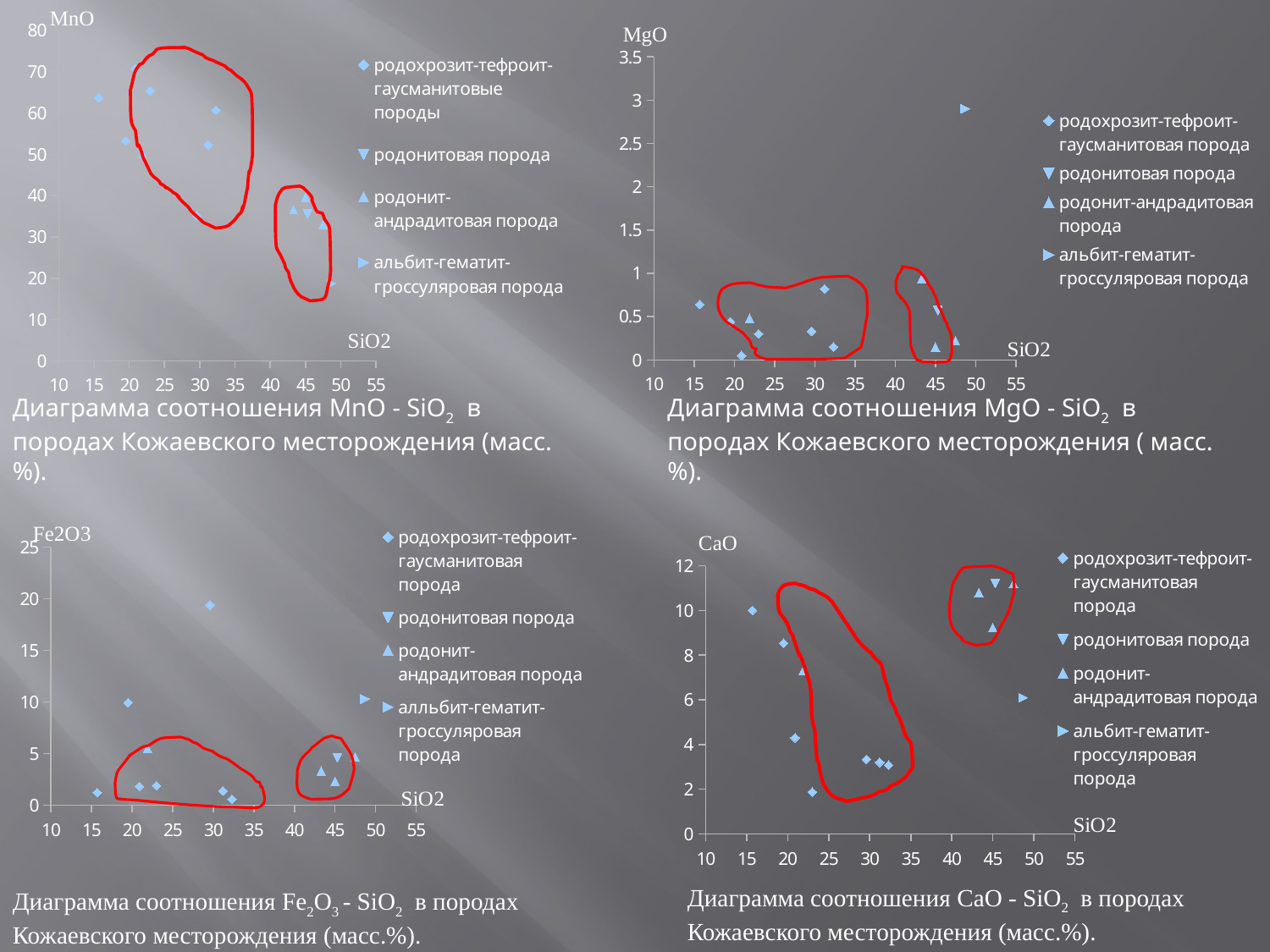
In the top-right chart (MgO - SiO2), which series has the point with the highest MgO value? альбит-гематит-гроссуляровая порода In the top-right chart (MgO - SiO2), is the MgO value for the 'альбит-гематит-гроссуляровая порода' point greater or less than 2.5? greater In the top-left chart (MnO - SiO2), which has higher MnO values: the 'родонит-андрадитовая порода' points or the 'альбит-гематит-гроссуляровая порода' point? родонит-андрадитовая порода In the bottom-right chart (CaO - SiO2), is the CaO value for the 'альбит-гематит-гроссуляровая порода' point greater or less than 4? greater In the top-left chart (MnO - SiO2), is the MnO value for the 'альбит-гематит-гроссуляровая порода' point greater or less than 30? less What kind of chart is the top-left chart titled 'Диаграмма соотношения MnO - SiO2'? scatter chart What is the label on the horizontal axis of the bottom-right chart (CaO chart)? SiO2 In the bottom-left chart (Fe2O3 - SiO2), how many series does the legend list? 4 In the top-left chart (MnO - SiO2), which series contains the point with the highest MnO value? родохрозит-тефроит-гаусманитовые породы In the top-right chart (MgO - SiO2), how many series does the legend list? 4 How many charts are shown on the slide? 4